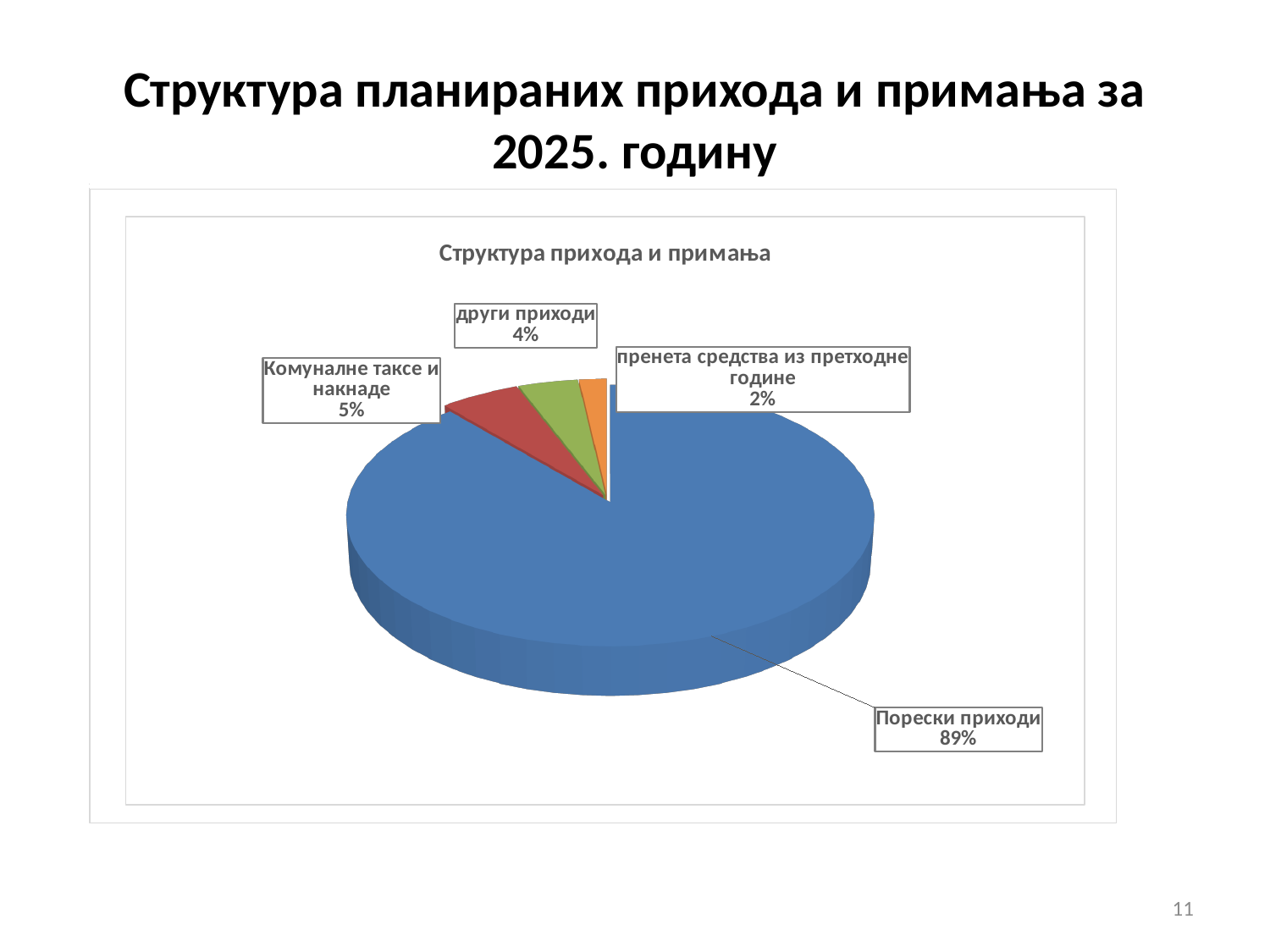
What share of the pie is други приходи? 4% How many slices does the pie chart have? 4 What is the chart's title? Структура прихода и примања What colour is the slice for Порески приходи? blue What share of the pie is Комуналне таксе и накнаде? 5% What share of the pie is пренета средства из претходне године? 2% What is the difference in percentage points between Порески приходи and Комуналне таксе и накнаде? 84 Which category has the smallest slice of the pie? пренета средства из претходне године What kind of chart is shown on the slide? pie chart Which is larger, the share for Комуналне таксе и накнаде or the share for други приходи? Комуналне таксе и накнаде Which category has the largest slice of the pie? Порески приходи